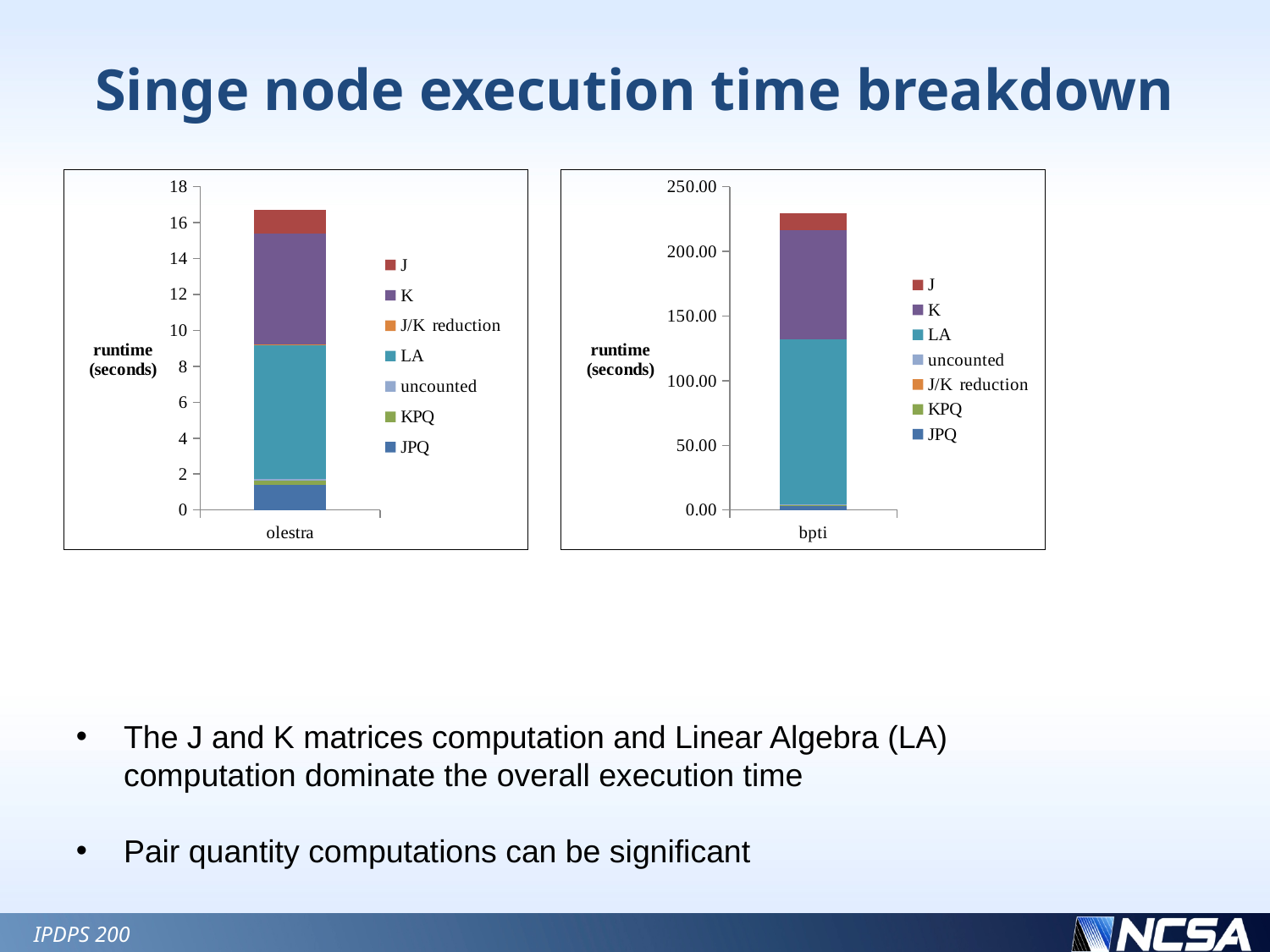
How many categories are shown on the x axis of the left chart (olestra)? 1 What is the category label on the x axis of the right chart? bpti In the right chart (bpti), is the top of the LA segment greater or less than 100.00? greater In the left chart (olestra), which segment is larger, K or J? K In the left chart (olestra), is the top of the LA segment greater or less than 10? less What is the y-axis title of the left chart (olestra)? runtime (seconds) In the right chart (bpti), is the total height of the stacked bar greater or less than 200.00? greater What kind of chart is the left chart (olestra)? stacked bar chart In the right chart (bpti), which segment is larger, J or JPQ? J How many series does the legend of the right chart (bpti) list? 7 In the right chart (bpti), which segment is larger, LA or K? LA